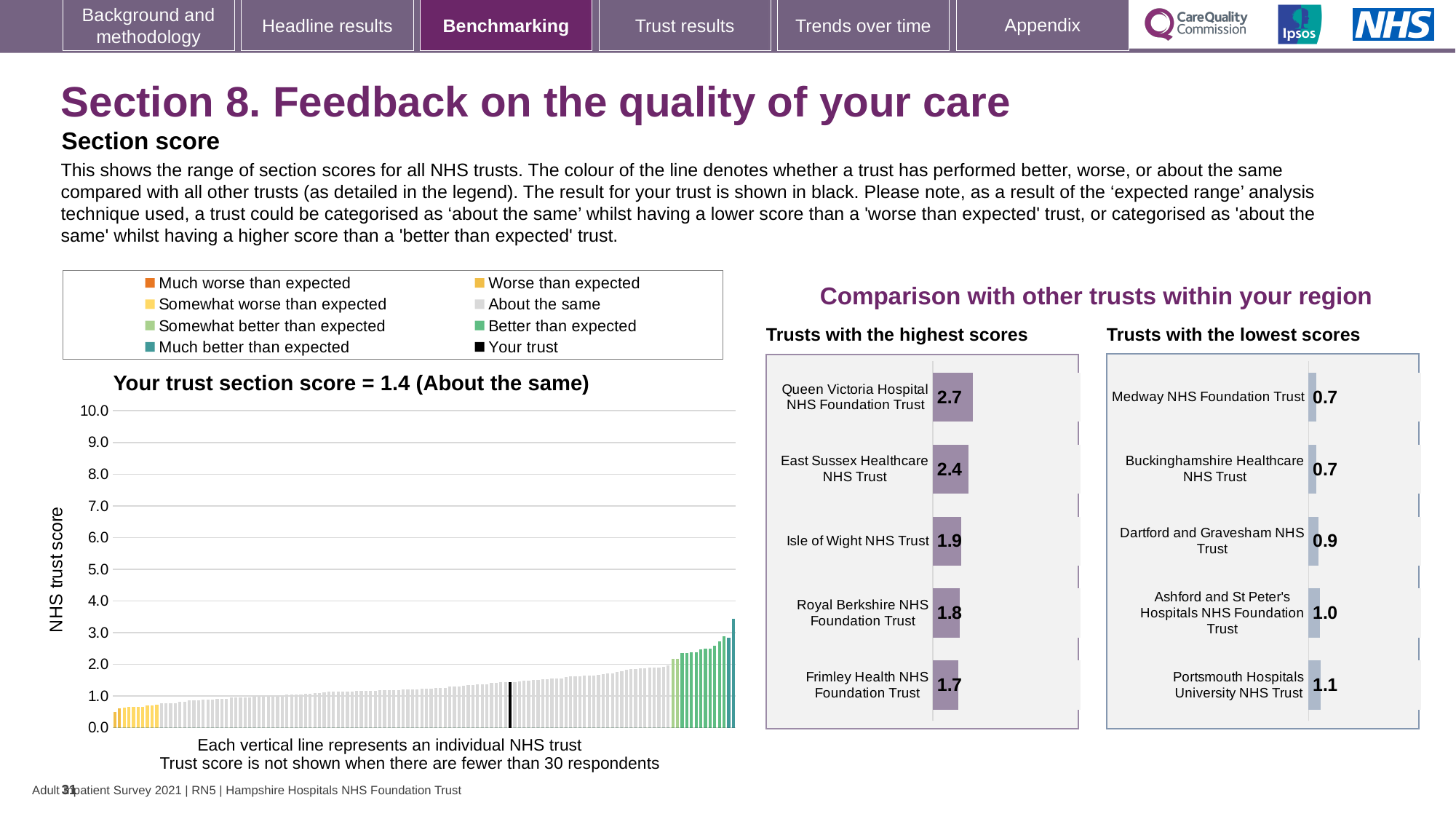
In the 'Trusts with the lowest scores' chart, which trust has the highest score? Portsmouth Hospitals University NHS Trust In the 'Your trust section score' chart, is the tallest bar greater or less than 3.0? greater How many trusts are shown in the 'Trusts with the lowest scores' chart? 5 In the 'Trusts with the highest scores' chart, which trust has the lowest score? Frimley Health NHS Foundation Trust In the 'Trusts with the highest scores' chart, what is the score for Queen Victoria Hospital NHS Foundation Trust? 2.7 In the 'Trusts with the highest scores' chart, what is the difference between the scores of Queen Victoria Hospital NHS Foundation Trust and Frimley Health NHS Foundation Trust? 1.0 In the 'Your trust section score' chart, which category does your trust fall into according to the chart title? About the same In the 'Your trust section score' chart, do the bars rise or fall from left to right? rise In the 'Your trust section score' chart, what is the section score for your trust? 1.4 How many entries does the legend above the 'Your trust section score' chart list? 8 What kind of chart is the 'Your trust section score' chart? bar chart In the 'Trusts with the lowest scores' chart, which has the larger score: Dartford and Gravesham NHS Trust or Ashford and St Peter's Hospitals NHS Foundation Trust? Ashford and St Peter's Hospitals NHS Foundation Trust